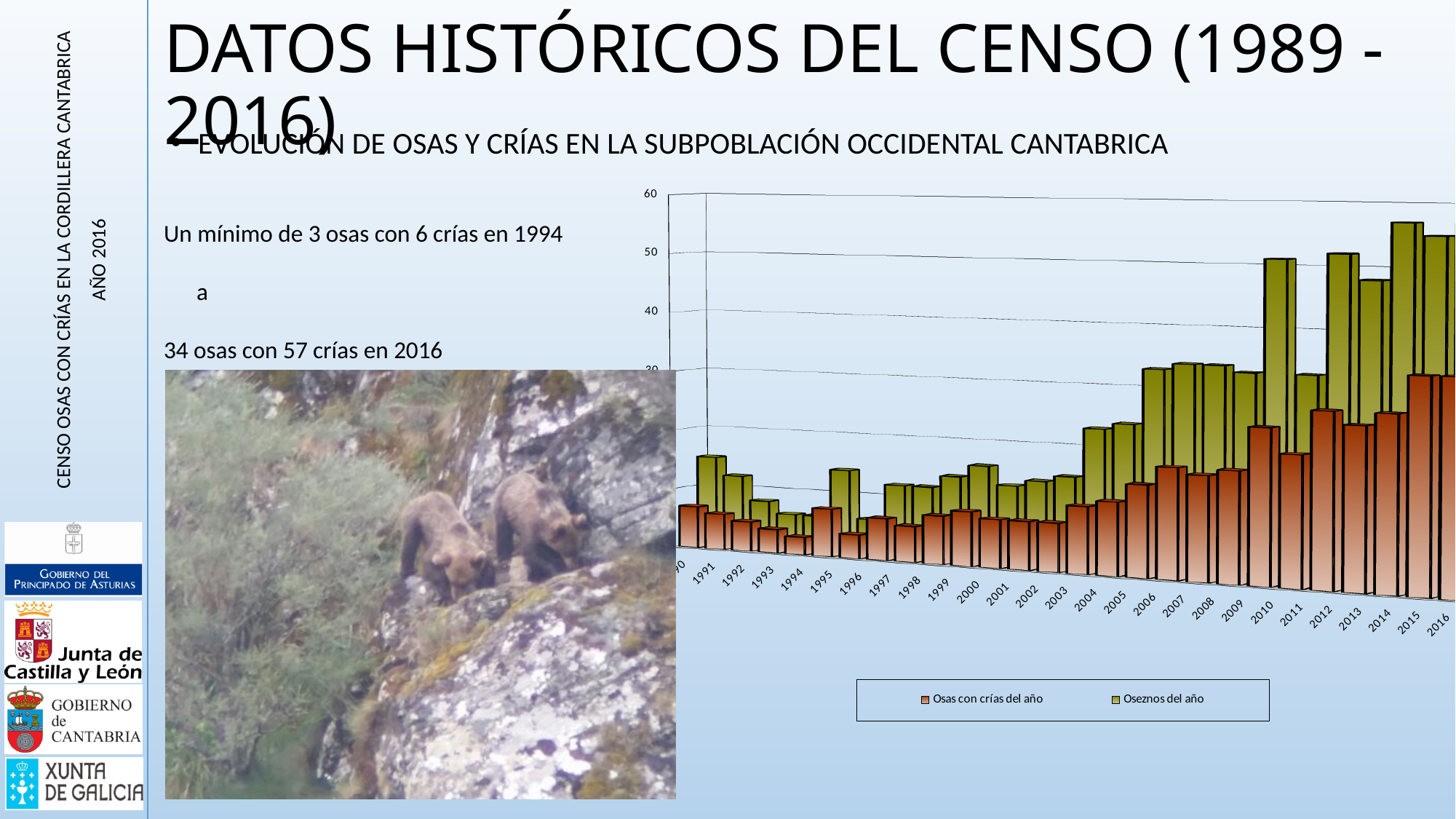
Overall, do the values for Osas con crías del año rise or fall from 1990 to 2016? rise What are the two series named in the chart legend? Osas con crías del año; Oseznos del año Which is larger, Oseznos del año in 2005 or in 1995? 2005 Which series is drawn in green/yellow bars? Oseznos del año How many series does the chart legend list? 2 Is the value for Oseznos del año in 2004 greater or less than 30? less Is the value for Osas con crías del año in 2016 greater or less than 20? greater Is the value for Oseznos del año in 2010 greater or less than 40? greater Which is larger, Oseznos del año in 2010 or in 2011? 2010 What kind of chart is shown on the slide? bar chart